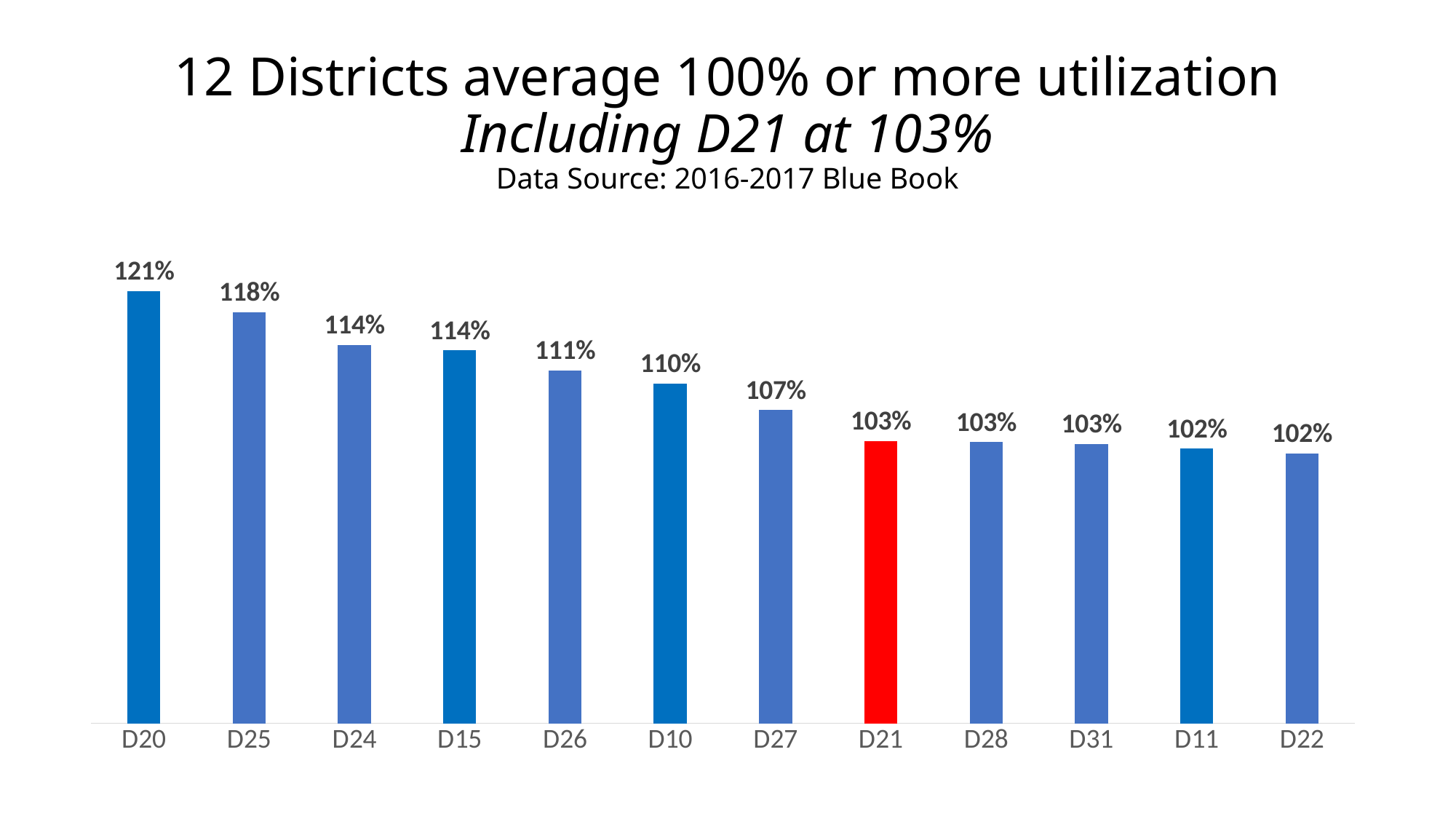
What is the difference between the utilization of D25 and D21? 15% What is the utilization value for D27? 107% What is the utilization value for D21? 103% Which has a higher utilization, D24 or D27? D24 What kind of chart is shown on the slide? Bar chart How many districts are shown in the chart? 12 Do the utilization values rise or fall from left to right along the x axis? Fall Which district has the highest utilization? D20 Which has a higher utilization, D26 or D10? D26 What is the utilization value for D25? 118% Which district's bar is coloured red? D21 What is the difference between the utilization of D20 and D22? 19%